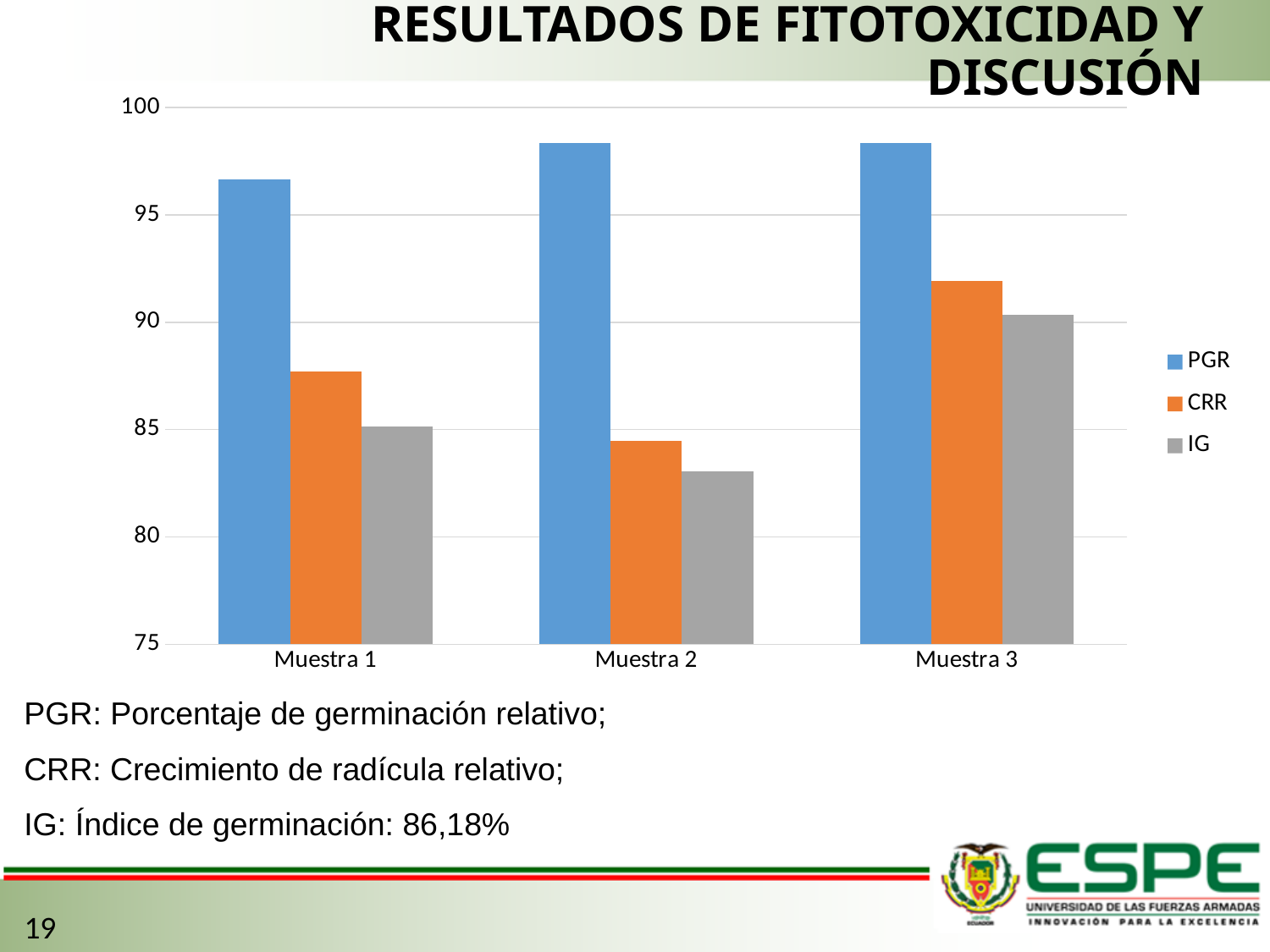
Which muestra has the highest CRR value? Muestra 3 Which muestra has the lowest IG value? Muestra 2 Is the CRR value for Muestra 3 greater or less than 90? greater Which muestra has the lowest CRR value? Muestra 2 What are the three entries listed in the legend? PGR, CRR, IG What kind of chart is shown on the slide? bar chart Is the PGR value for Muestra 1 greater or less than 95? greater How many series does the legend list? 3 How many categories (muestras) are shown on the x axis? 3 Is the IG value for Muestra 2 greater or less than 85? less In Muestra 3, which is larger, the CRR value or the IG value? CRR Which muestra has the lowest PGR value? Muestra 1